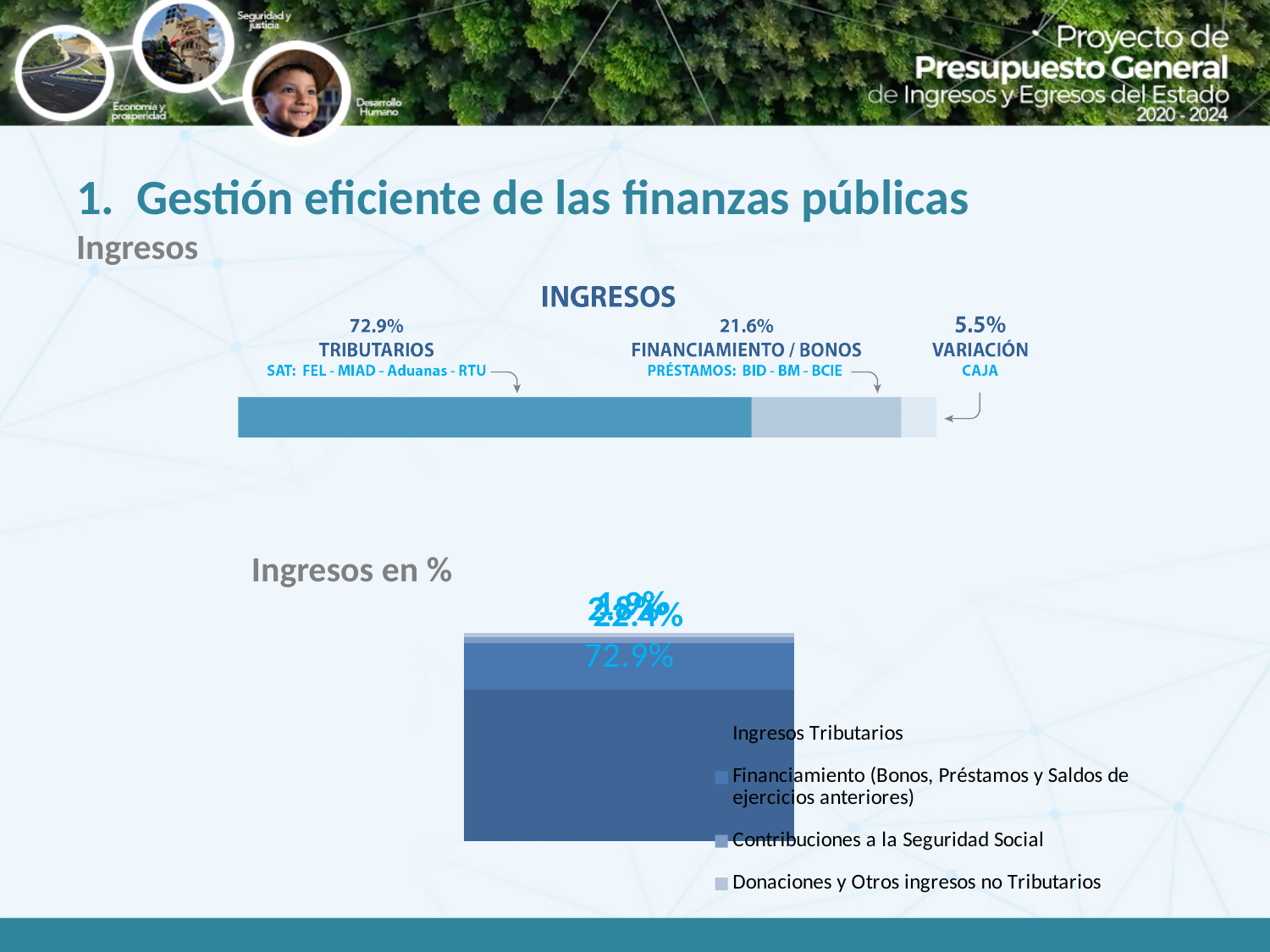
In the INGRESOS bar graphic at the top, what is the difference between the TRIBUTARIOS and FINANCIAMIENTO / BONOS percentages? 51.3% In the 'Ingresos en %' chart, which series has the largest segment? Ingresos Tributarios What kind of chart is the 'Ingresos en %' chart? bar chart In the 'Ingresos en %' chart, how many stacked bars are plotted? 1 In the INGRESOS bar graphic at the top, what percentage is shown for TRIBUTARIOS? 72.9% In the INGRESOS bar graphic at the top, what percentage is shown for FINANCIAMIENTO / BONOS? 21.6% In the 'Ingresos en %' chart, how many series does the legend list? 4 In the 'Ingresos en %' chart, which is larger: Ingresos Tributarios or Financiamiento (Bonos, Préstamos y Saldos de ejercicios anteriores)? Ingresos Tributarios What is the title of the stacked bar chart at the bottom of the slide? Ingresos en % In the INGRESOS bar graphic at the top, what percentage is shown for VARIACIÓN CAJA? 5.5% In the 'Ingresos en %' chart, what is the value for Ingresos Tributarios? 72.9% In the 'Ingresos en %' chart, what is the last legend entry? Donaciones y Otros ingresos no Tributarios